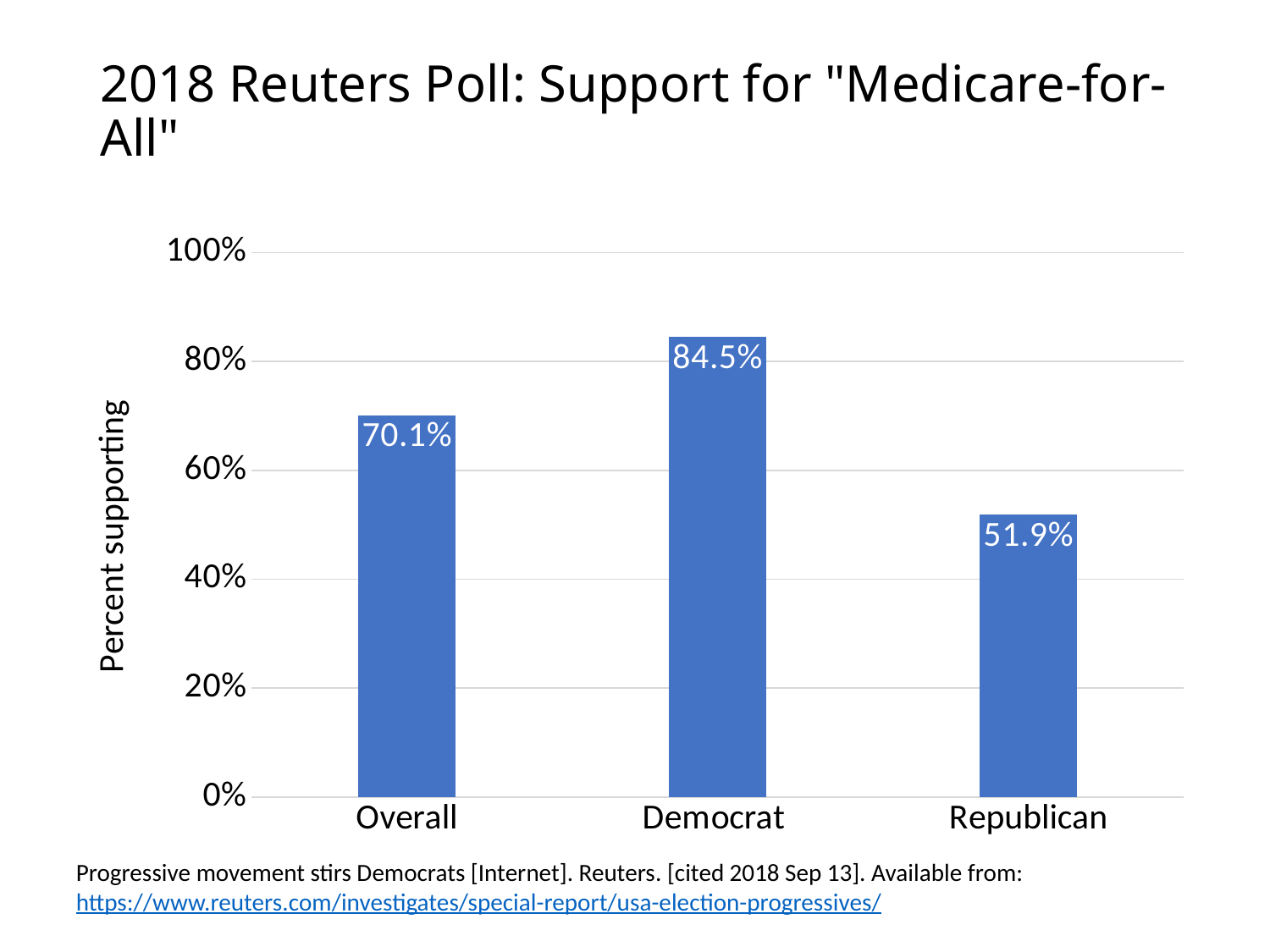
What is the difference in percent supporting between Democrat and Overall? 14.4% Which category has the highest percent supporting? Democrat Is the value for Republican greater or less than 60%? less What is the label of the vertical axis? Percent supporting What is the percent supporting for Democrat? 84.5% What is the percent supporting for Overall? 70.1% What is the difference in percent supporting between Democrat and Republican? 32.6% How many categories are shown on the x axis? 3 What is the percent supporting for Republican? 51.9% What kind of chart is shown on the slide? bar chart Which is larger, the percent supporting for Overall or for Republican? Overall Which category has the lowest percent supporting? Republican